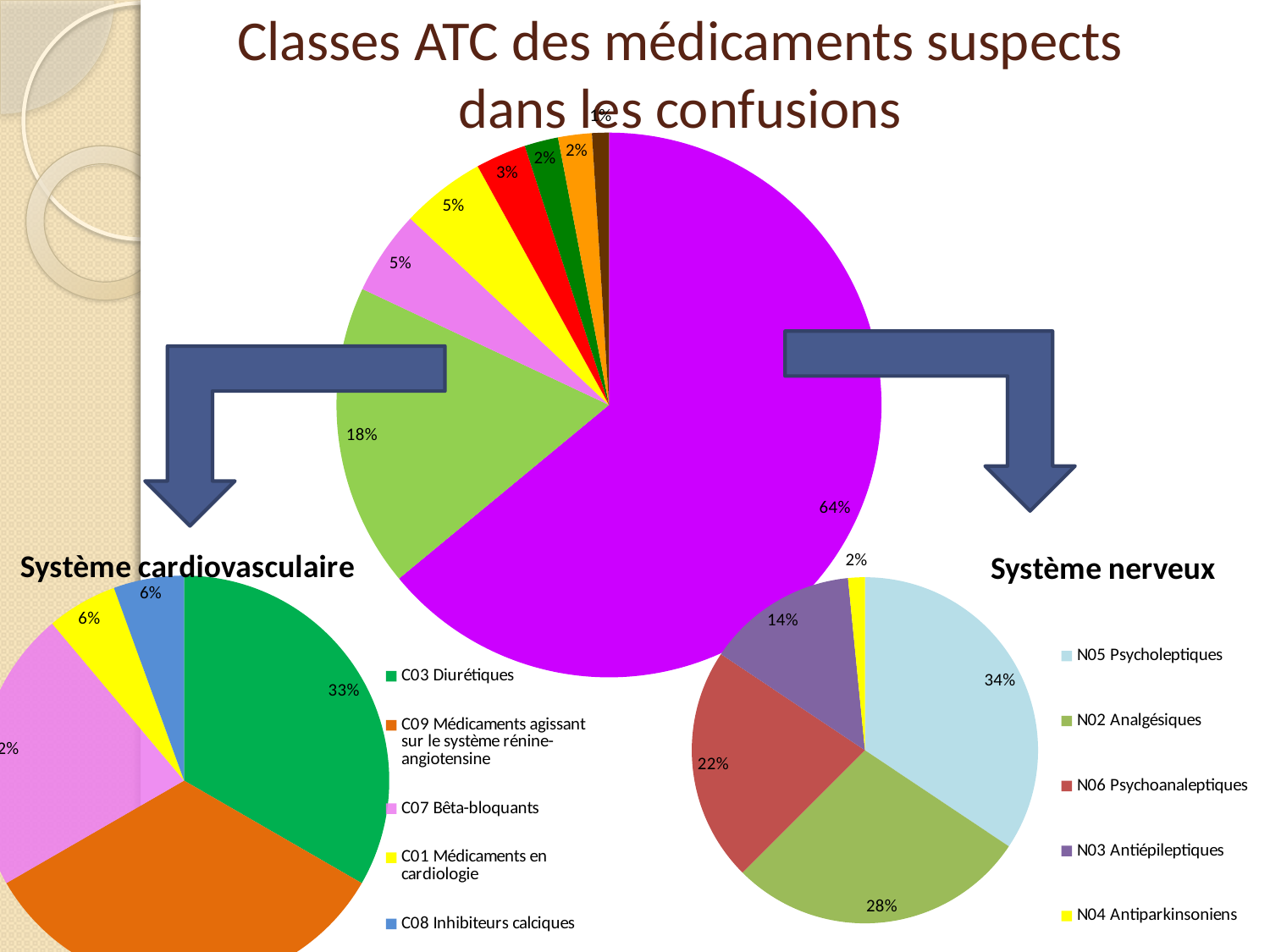
On the 'Système nerveux' pie chart, what share is N06 Psychoanaleptiques? 22% On the large central pie chart, what is the share of the largest slice? 64% On the 'Système cardiovasculaire' pie chart, what share is C03 Diurétiques? 33% On the 'Système nerveux' pie chart, what is the difference between the shares of N05 Psycholeptiques and N06 Psychoanaleptiques? 12% On the 'Système cardiovasculaire' pie chart, how many categories does the legend list? 5 On the 'Système nerveux' pie chart, which category has the largest share? N05 Psycholeptiques On the 'Système nerveux' pie chart, what share is N03 Antiépileptiques? 14% On the 'Système nerveux' pie chart, which category has the smallest share? N04 Antiparkinsoniens On the 'Système cardiovasculaire' pie chart, what share is C08 Inhibiteurs calciques? 6% On the 'Système nerveux' pie chart, how many categories does the legend list? 5 On the 'Système nerveux' pie chart, what share is N05 Psycholeptiques? 34% On the 'Système nerveux' pie chart, what share is N02 Analgésiques? 28%